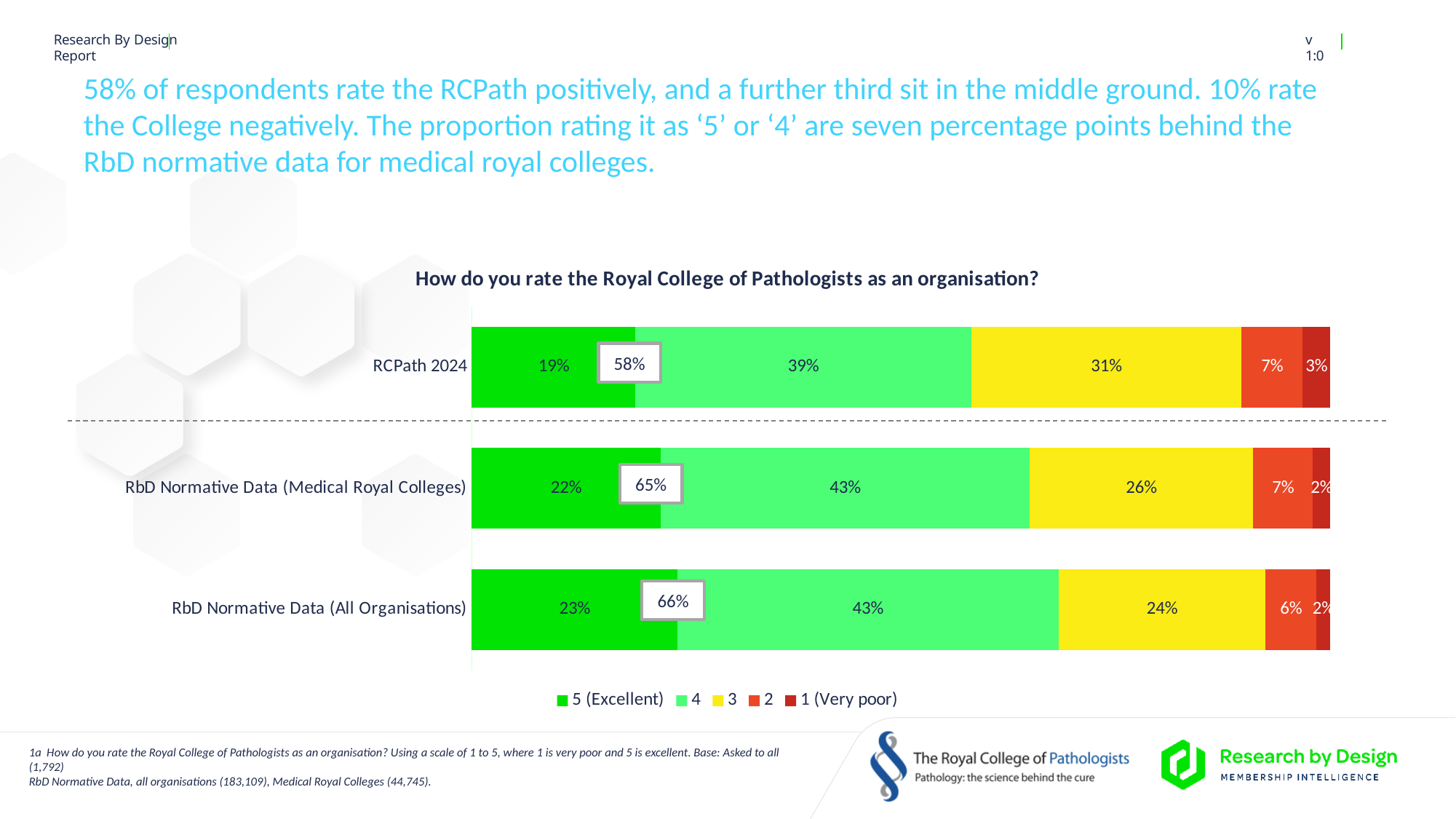
How many categories (bars) are shown in the chart? 3 Which category has the lowest share of 5 (Excellent) ratings? RCPath 2024 What type of chart is shown on the slide? Stacked bar chart What percentage of RCPath 2024 respondents gave a rating of 3? 31% What is the difference between the rating 3 share for RCPath 2024 and for RbD Normative Data (All Organisations)? 7 percentage points Is the share of rating 4 larger for RCPath 2024 or for RbD Normative Data (Medical Royal Colleges)? RbD Normative Data (Medical Royal Colleges) What is the value for rating 4 in the RbD Normative Data (Medical Royal Colleges) bar? 43% What percentage of RCPath 2024 respondents rated the College as 5 (Excellent)? 19% What percentage of RbD Normative Data (All Organisations) respondents gave a rating of 2? 6% How many series does the legend list? 5 Which category has the highest share of 5 (Excellent) ratings? RbD Normative Data (All Organisations) What is the combined '5' or '4' figure shown in the box for RCPath 2024? 58%